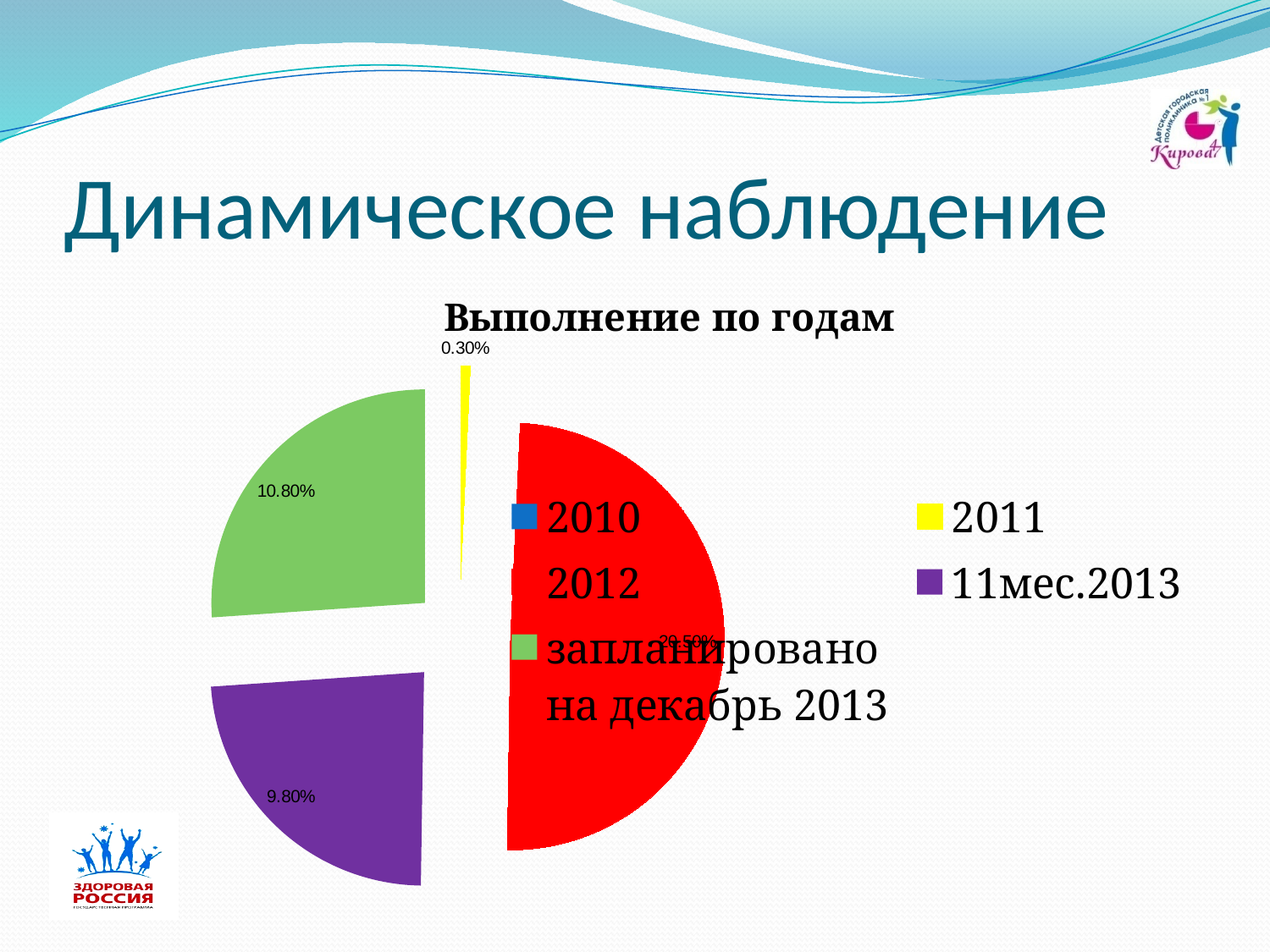
Which category has the largest slice of the pie? 2012 Which is larger, the slice for 11мес.2013 or the slice for запланировано на декабрь 2013? запланировано на декабрь 2013 What is the title of the chart? Выполнение по годам What is the difference between the values for запланировано на декабрь 2013 and 11мес.2013? 1.00% What is the value shown for запланировано на декабрь 2013? 10.80% What kind of chart is shown on the slide? pie chart What is the value shown for 11мес.2013? 9.80% Which is larger, the slice for 2011 or the slice for 11мес.2013? 11мес.2013 How many entries does the chart legend list? 5 What is the value shown for 2011? 0.30% What colour is the slice for 2012? red